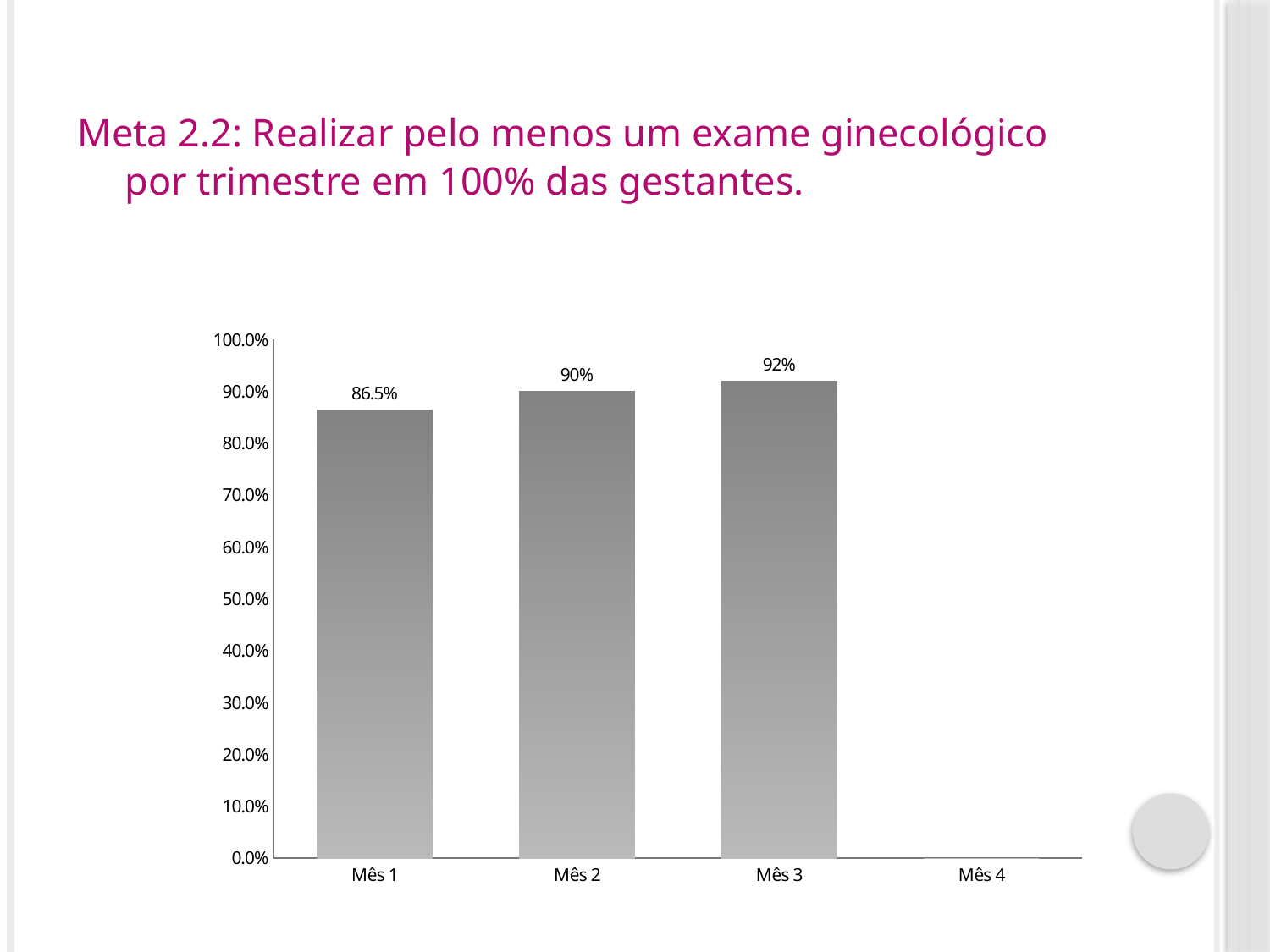
What kind of chart is shown on the slide? bar chart Which month has the highest value? Mês 3 Is the value for Mês 1 greater or less than 90.0%? less What is the value for Mês 1? 86.5% Among the months that have a bar plotted, which has the lowest value? Mês 1 Which is larger, the value for Mês 1 or the value for Mês 3? Mês 3 What is the difference in percentage points between Mês 2 and Mês 1? 3.5 percentage points What is the difference in percentage points between Mês 3 and Mês 2? 2 percentage points How many categories are shown on the x axis? 4 What is the value for Mês 2? 90% Do the values rise or fall from Mês 1 to Mês 3? rise What is the value for Mês 3? 92%